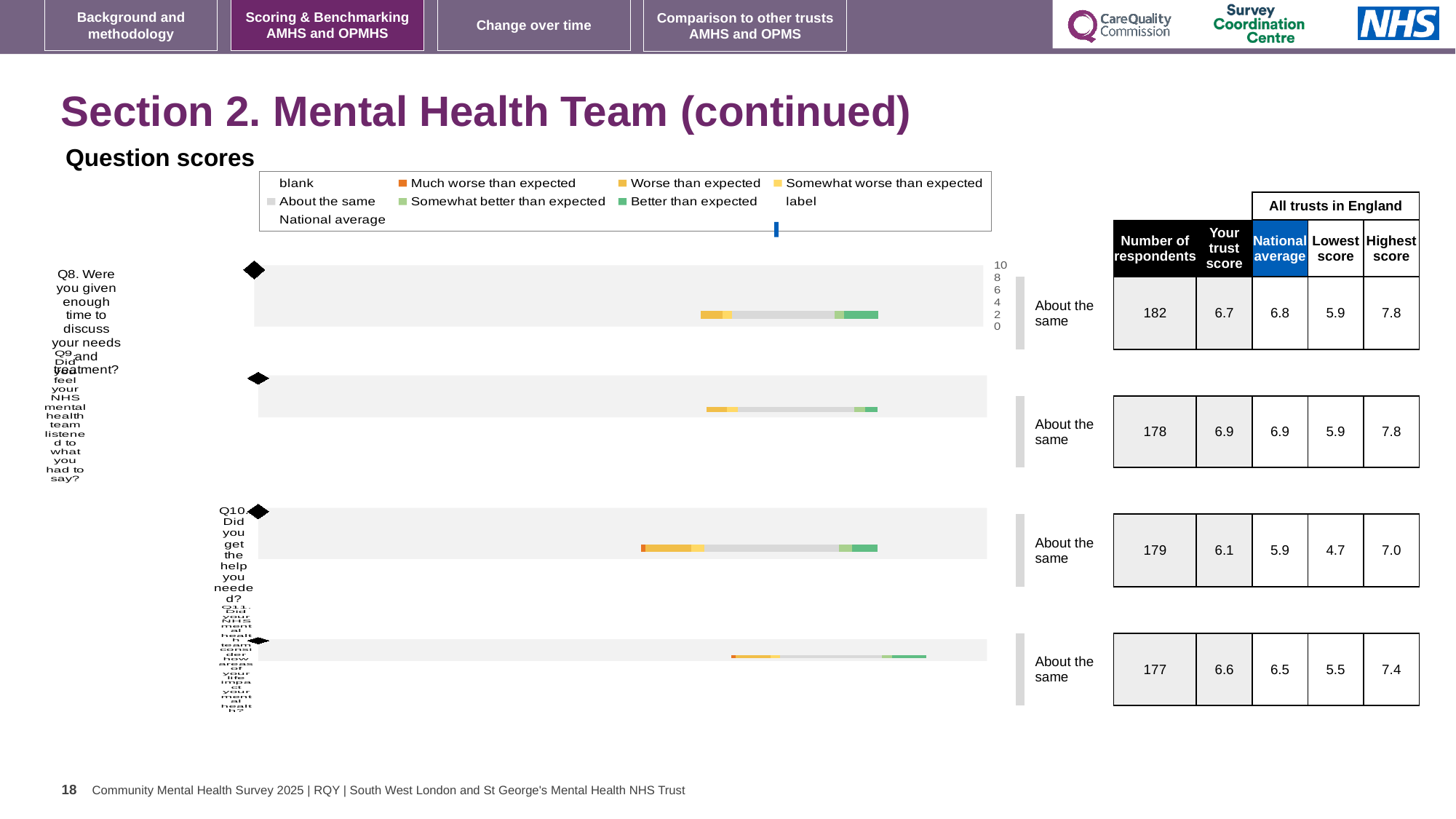
What benchmark label is printed to the right of the Q8 chart? About the same What benchmark label is printed to the right of the Q10 chart? About the same Which legend entry is shown in grey? About the same What kind of chart is used for the Q8 question score? bar chart What benchmark label is printed to the right of the Q11 chart? About the same How many question-score charts are shown on the slide? 4 Which question's chart is the first (topmost) on the slide? Q8 What is the highest tick value shown on the axis of the Q8 chart? 10 Which question's chart is the last (bottom) on the slide? Q11